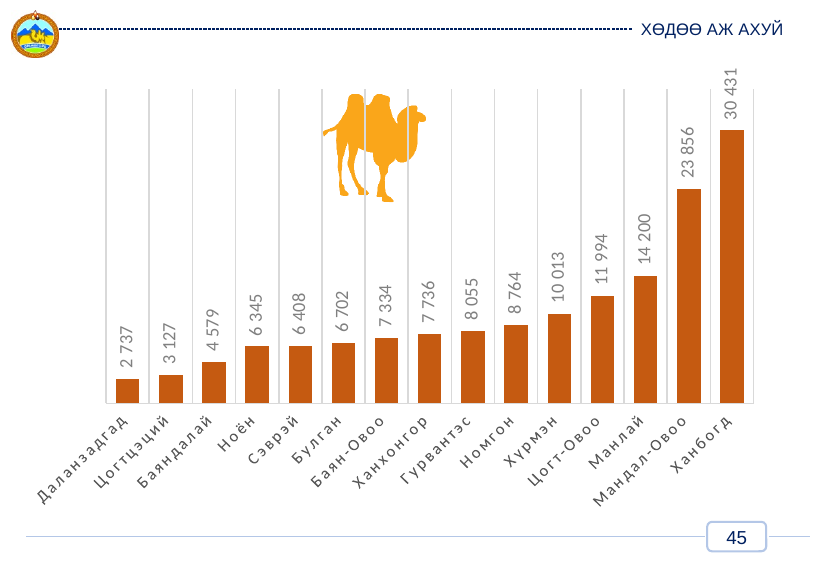
What is the value for Ханбогд? 30 431 Which is larger, the value for Номгон or the value for Ханхонгор? Номгон What is the value for Манлай? 14 200 What kind of chart is shown on the slide? Bar chart What is the difference between the values for Цогт-Овоо and Хүрмэн? 1 981 What is the difference between the values for Ханбогд and Мандал-Овоо? 6 575 What is the value for Даланзадгад? 2 737 Which category has the highest value? Ханбогд What is the value for Гурвантэс? 8 055 How many categories are shown in the chart? 15 Which category has the lowest value? Даланзадгад Do the values rise or fall from left to right along the x axis? Rise